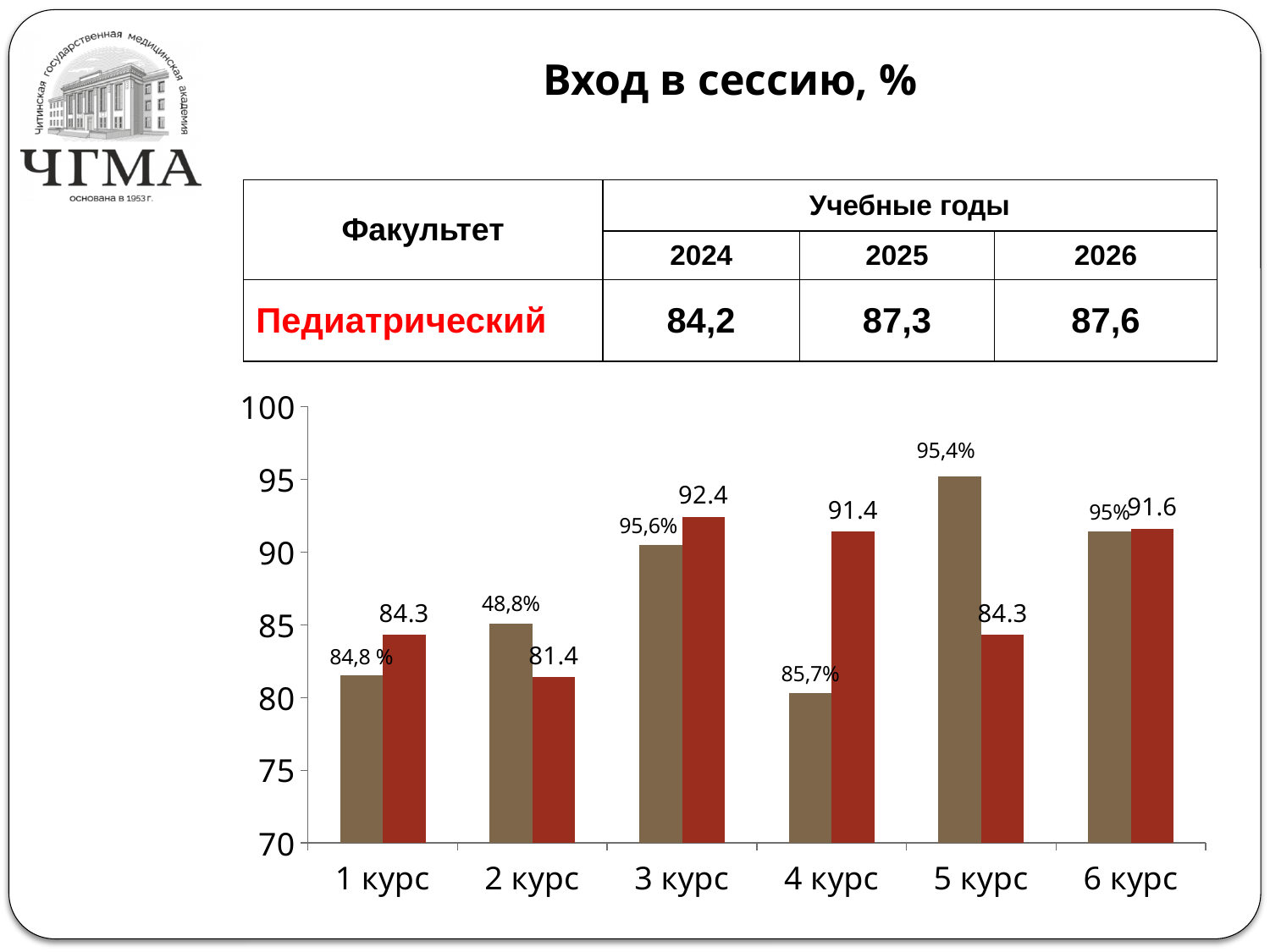
How many categories (курс groups) are shown on the x axis of the chart? 6 What kind of chart is shown on the slide? bar chart What is the value of the red bar for 1 курс? 84.3 Which category has the lowest red bar? 2 курс Which has the larger red bar value, 4 курс or 5 курс? 4 курс What is the difference between the red bar values for 3 курс and 2 курс? 11.0 What is the value of the red bar for 6 курс? 91.6 What is the title of the chart on the slide? Вход в сессию, % Which category has the highest red bar? 3 курс What is the value of the red bar for 2 курс? 81.4 Is the brown bar for 4 курс greater or less than 85? less What is the value of the red bar for 3 курс? 92.4